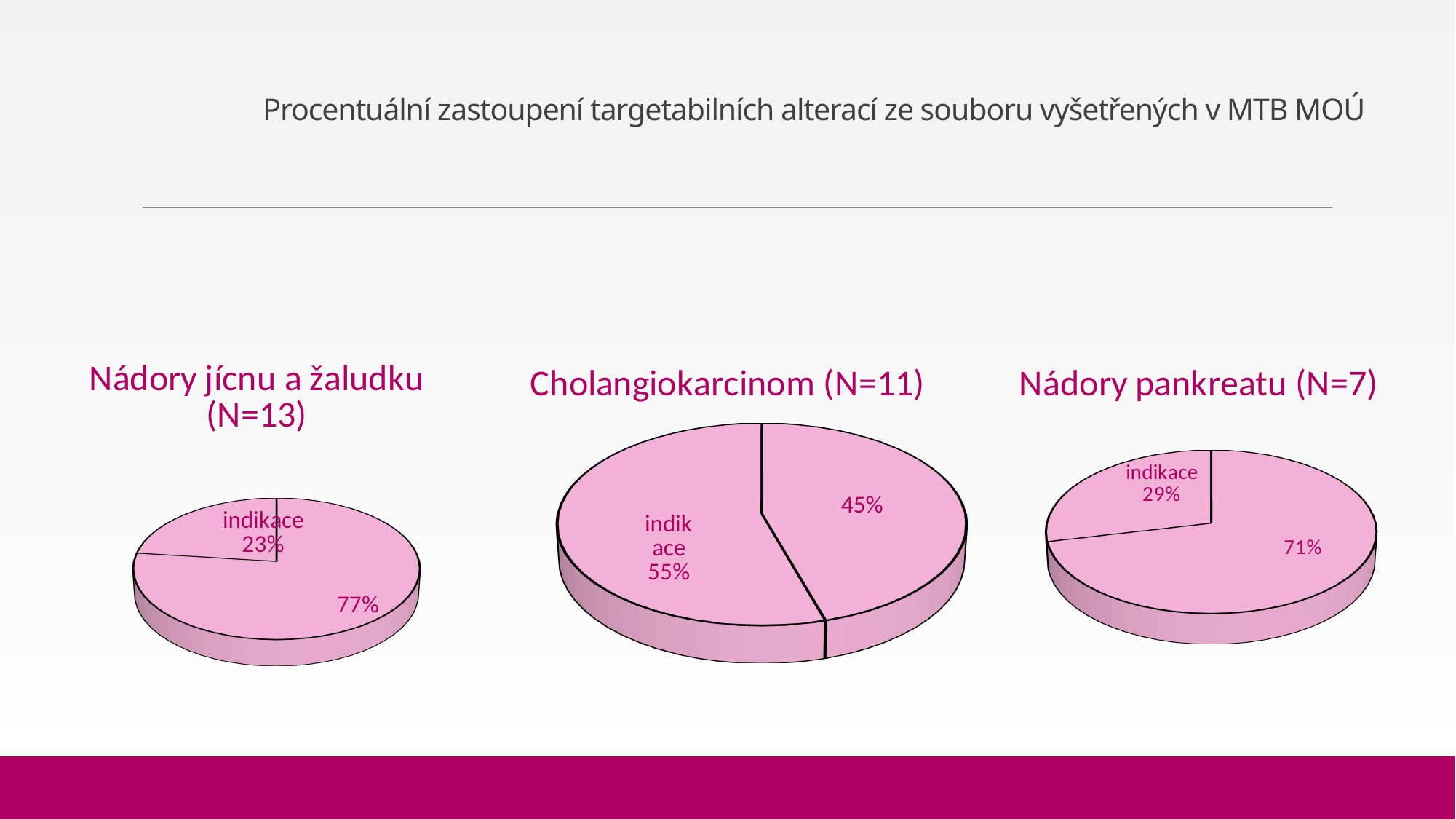
How many pie charts are shown on the slide? 3 What type of chart is used for 'Cholangiokarcinom (N=11)'? Pie chart Which of the three pie charts has the smallest 'indikace' share? Nádory jícnu a žaludku (N=13) Which of the three pie charts has the largest 'indikace' share? Cholangiokarcinom (N=11) In the 'Nádory jícnu a žaludku (N=13)' pie chart, what percentage is shown on the slice that is not labelled 'indikace'? 77% In the 'Nádory jícnu a žaludku (N=13)' pie chart, what share is labelled 'indikace'? 23% In the 'Cholangiokarcinom (N=11)' pie chart, what share is labelled 'indikace'? 55% In the 'Cholangiokarcinom (N=11)' pie chart, what percentage is shown on the slice that is not labelled 'indikace'? 45% In the 'Nádory pankreatu (N=7)' pie chart, what share is labelled 'indikace'? 29% In the 'Nádory pankreatu (N=7)' pie chart, what percentage is shown on the slice that is not labelled 'indikace'? 71% In the 'Cholangiokarcinom (N=11)' pie chart, what is the difference between the 'indikace' slice and the other slice? 10% How many slices does the 'Nádory pankreatu (N=7)' pie chart have? 2